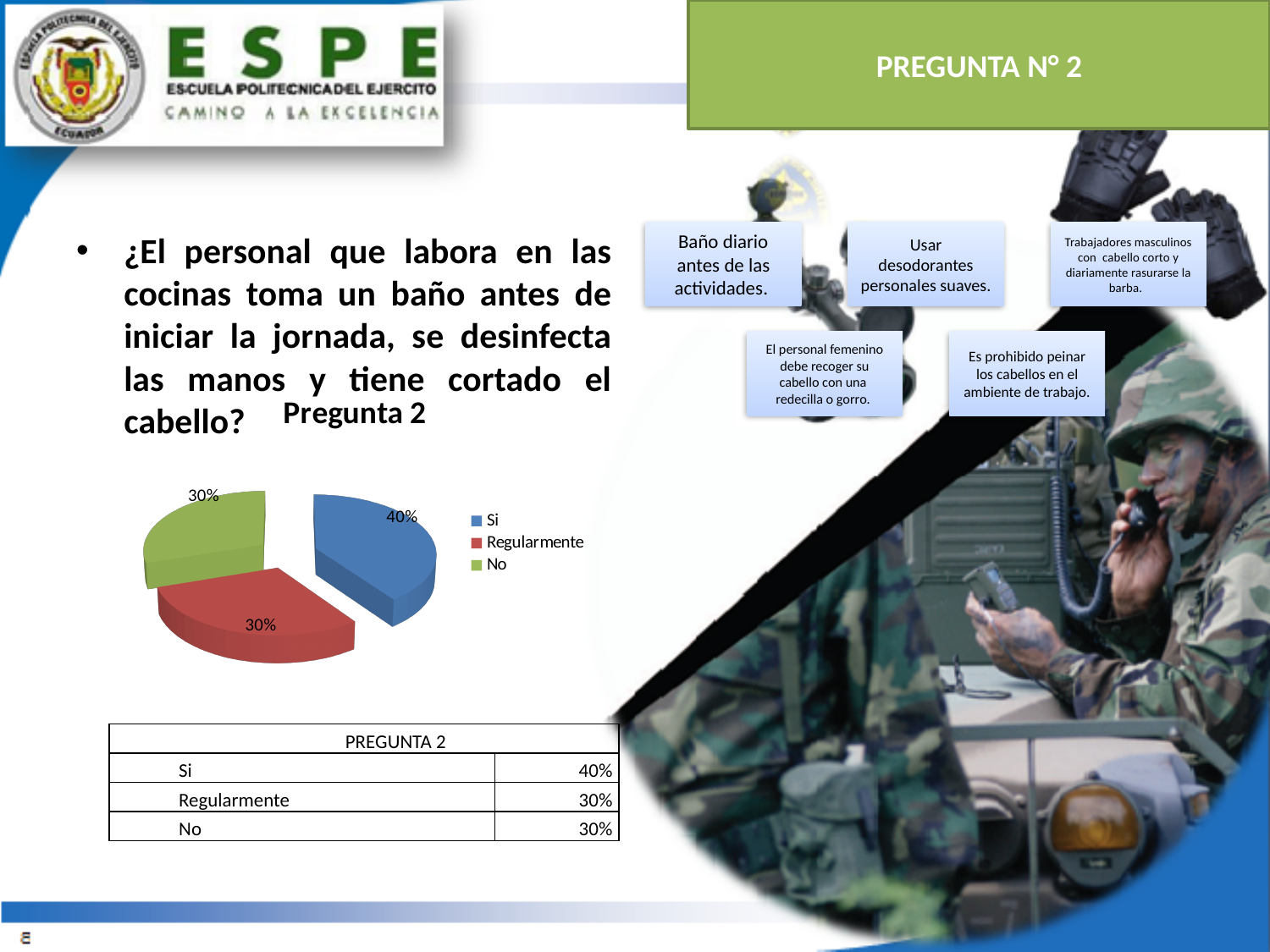
Which is larger in the pie chart, "Si" or "No"? Si What is the title of the pie chart? Pregunta 2 What kind of chart is shown on the slide? pie chart Which category has the largest slice in the pie chart? Si How many entries does the legend of the pie chart list? 3 What percentage of the pie chart corresponds to "No"? 30% What percentage of the pie chart corresponds to "Regularmente"? 30% What percentage of the pie chart corresponds to "Si"? 40% How many slices does the pie chart have? 3 What share of the pie does the "Si" slice represent? 40% What is the difference between the "Si" and "Regularmente" slices? 10% What colour is the "Si" slice in the pie chart? blue